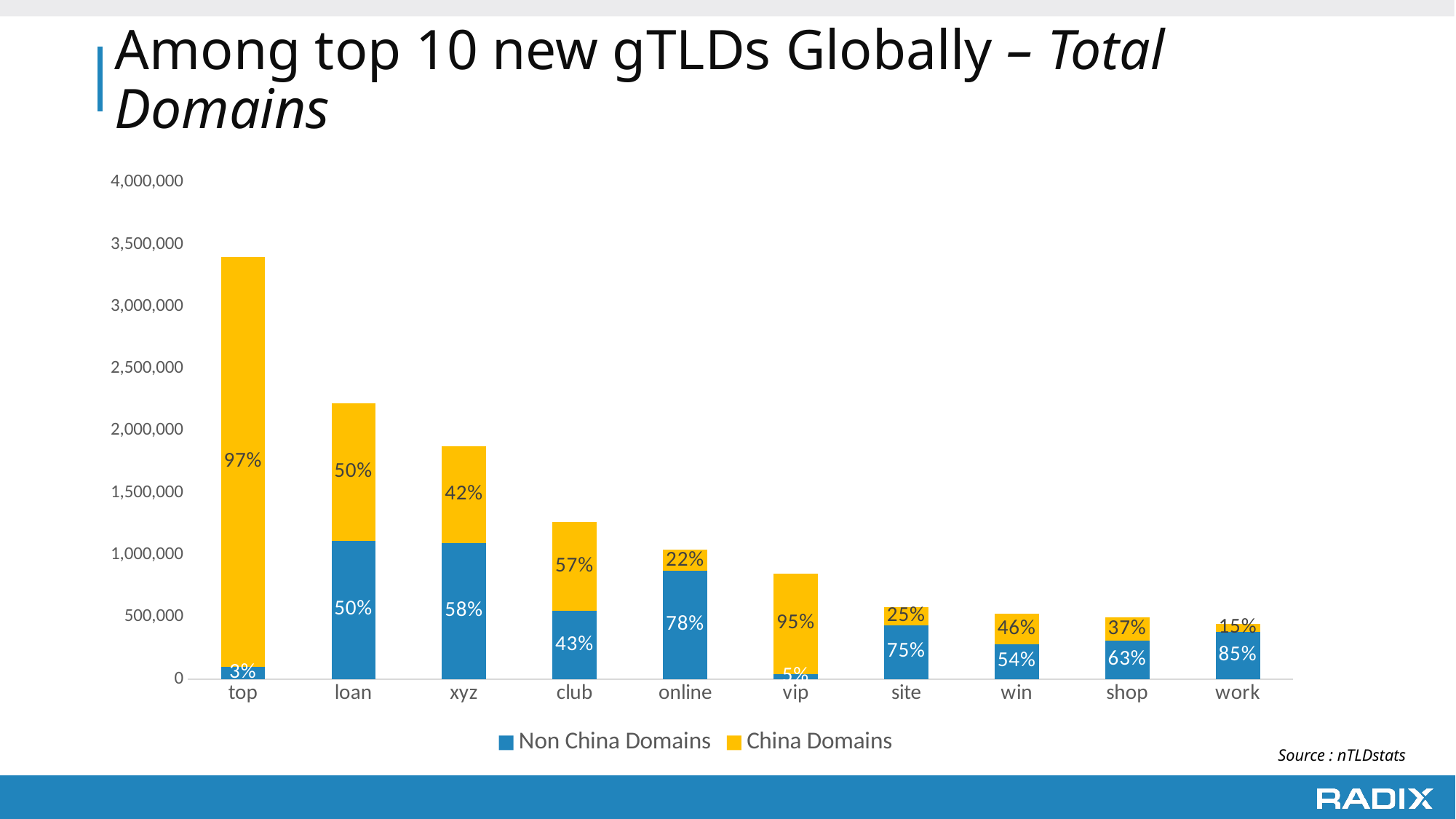
What kind of chart is shown on the slide? Stacked bar chart Which gTLD has the tallest total bar in the chart? top Is the total bar for 'vip' greater or less than 1,000,000? less What percentage label is shown for China Domains on the 'vip' bar? 95% How many gTLDs are shown along the x axis of the chart? 10 Which has the larger total bar, 'loan' or 'xyz'? loan What percentage label is shown for Non China Domains on the 'online' bar? 78% Is the total bar for 'loan' greater or less than 2,000,000? greater How many series does the chart's legend list? 2 Which gTLD has the lowest Non China Domains percentage label? top Do the total bar heights rise or fall from left to right across the x axis? fall What percentage label is shown for China Domains on the 'top' bar? 97%